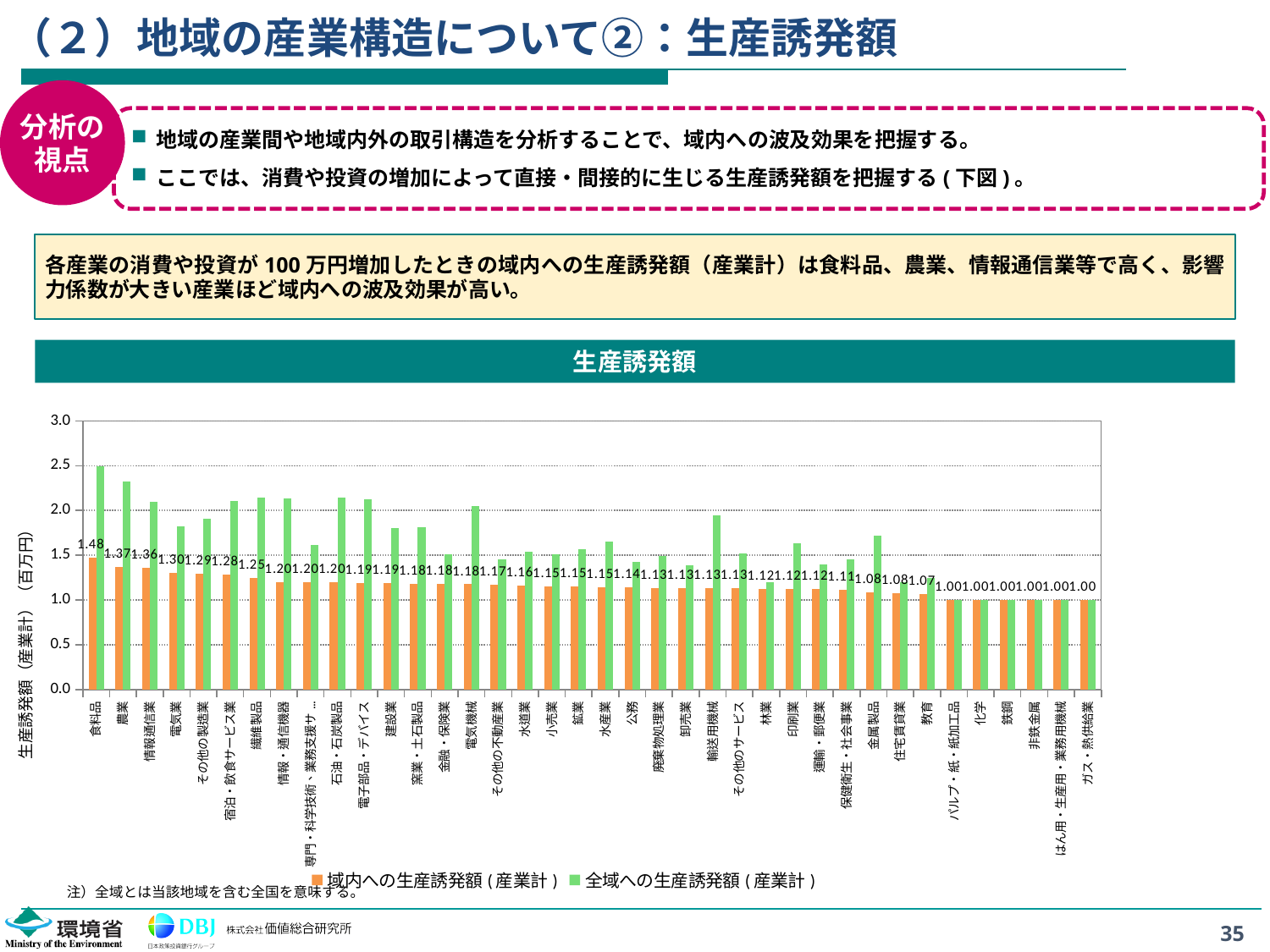
What is the value of 域内への生産誘発額(産業計) for 食料品? 1.48 What is the value of 域内への生産誘発額(産業計) for 電気業? 1.30 Is the 全域への生産誘発額(産業計) value for 輸送用機械 greater or less than 1.5? greater What is the value of 域内への生産誘発額(産業計) for 農業? 1.37 Do the 域内への生産誘発額(産業計) values rise or fall from left to right along the x axis? Fall What kind of chart is shown? Bar chart How many series does the legend list? 2 Which industry has the highest 域内への生産誘発額(産業計)? 食料品 What is the difference between the 域内への生産誘発額(産業計) values for 食料品 and 農業? 0.11 Is the 全域への生産誘発額(産業計) value for 食料品 greater or less than 2.0? greater Which has the larger 域内への生産誘発額(産業計), 情報通信業 or 電気業? 情報通信業 What is the label of the vertical axis? 生産誘発額（産業計）（百万円）